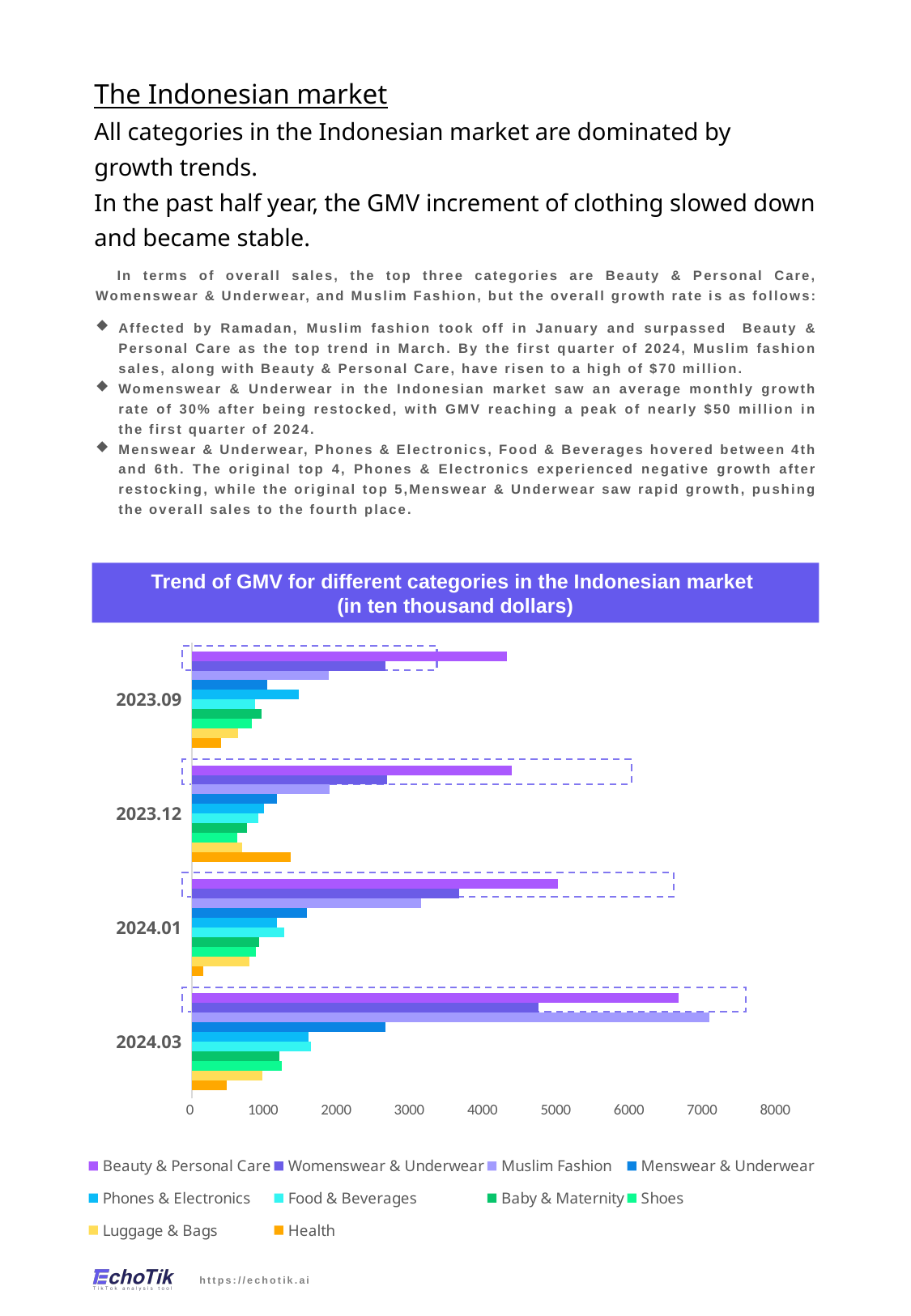
What is the title of the chart? Trend of GMV for different categories in the Indonesian market (in ten thousand dollars) Is the value for Womenswear & Underwear in 2024.01 greater or less than 3000? greater Is the value for Health in 2024.01 greater or less than 1000? less Is the value for Beauty & Personal Care in 2024.03 greater or less than 6000? greater Does the GMV of Beauty & Personal Care rise or fall from 2023.09 to 2024.03? rise Which category has the highest GMV in 2023.09? Beauty & Personal Care What kind of chart is shown on the slide? bar chart Which category has the highest GMV in 2024.03? Muslim Fashion Which category has the lowest GMV in 2024.01? Health How many time periods are shown on the vertical axis of the chart? 4 How many series does the chart legend list? 10 In 2023.12, which is larger: Beauty & Personal Care or Womenswear & Underwear? Beauty & Personal Care